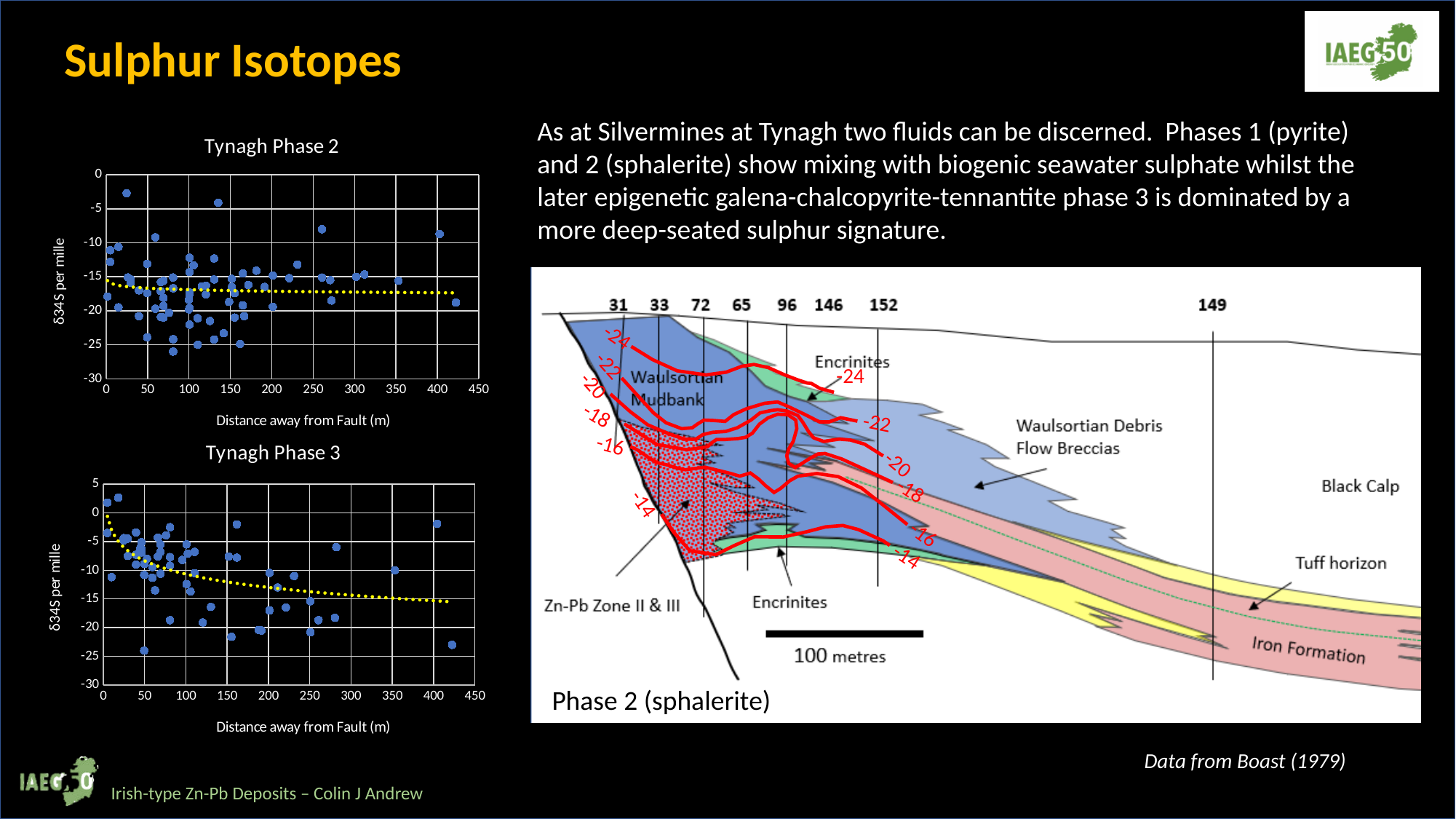
In the Tynagh Phase 3 chart, is the dotted trend line at 400 m greater or less than -10 per mille? less In the Tynagh Phase 2 chart, is the lowest plotted point greater or less than -25 per mille? less What is the maximum value shown on the x axis of the Tynagh Phase 2 chart? 450 What kind of chart is the Tynagh Phase 3 chart? scatter chart What is the x-axis label of the Tynagh Phase 3 chart? Distance away from Fault (m) What kind of chart is the Tynagh Phase 2 chart? scatter chart In the Tynagh Phase 2 chart, is the dotted trend line at 0 m greater or less than -20 per mille? greater In the Tynagh Phase 3 chart, does the dotted trend line rise or fall as distance from the fault increases? fall What is the title of the upper chart on the left of the slide? Tynagh Phase 2